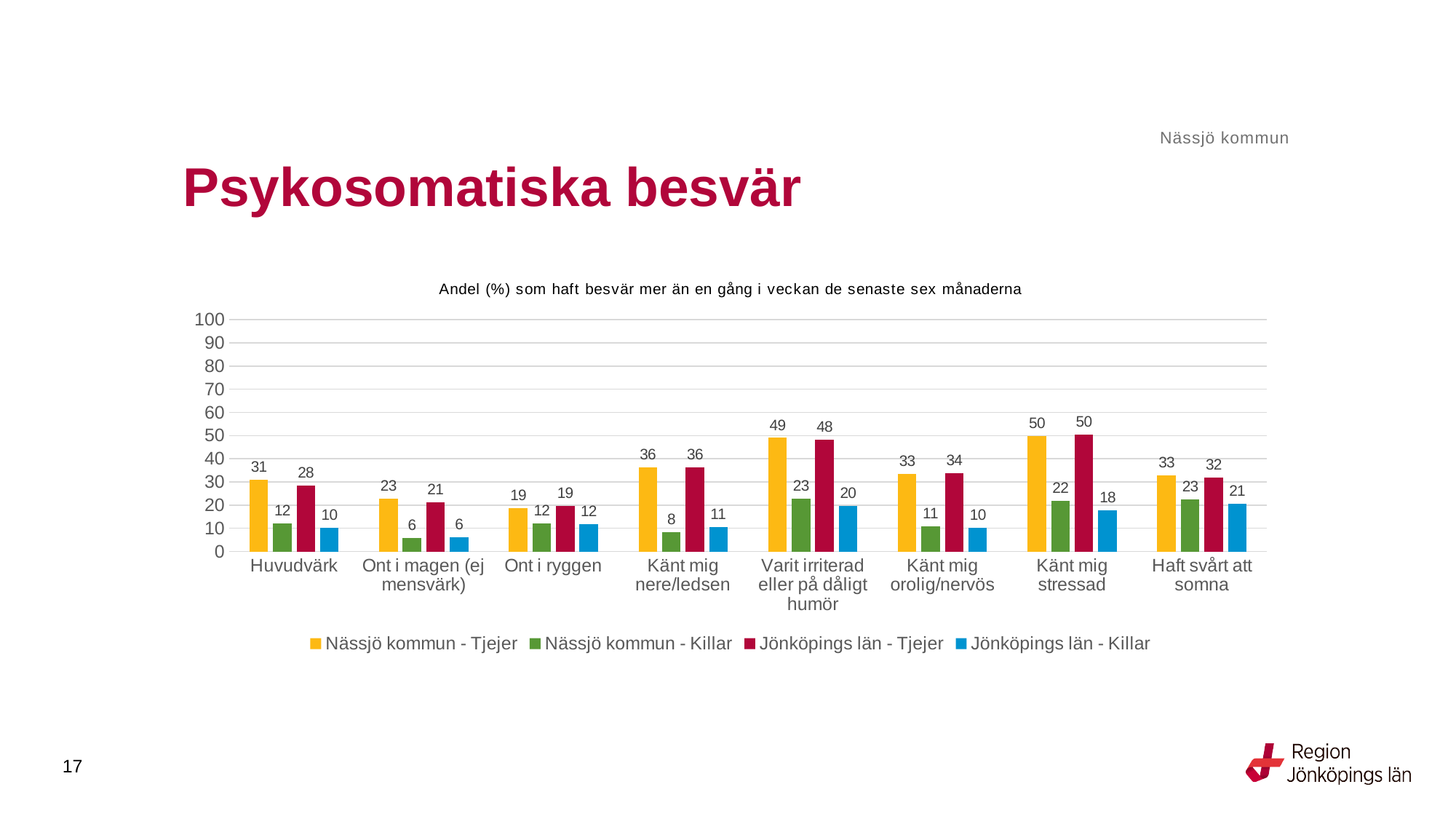
What is the value for Jönköpings län - Killar for Varit irriterad eller på dåligt humör? 20 How many categories are shown on the x axis? 8 What is the difference between Nässjö kommun - Tjejer and Nässjö kommun - Killar for Känt mig nere/ledsen? 28 Is the value for Jönköpings län - Tjejer for Känt mig stressad greater or less than 40? greater Which category has the highest value for Nässjö kommun - Tjejer? Känt mig stressad What kind of chart is shown on the slide? Bar chart What is the value for Nässjö kommun - Tjejer for Huvudvärk? 31 Which is larger for Känt mig orolig/nervös: Nässjö kommun - Tjejer or Jönköpings län - Tjejer? Jönköpings län - Tjejer How many series does the legend list? 4 Which category has the lowest value for Nässjö kommun - Killar? Ont i magen (ej mensvärk) What is the value for Nässjö kommun - Killar for Haft svårt att somna? 23 What is the subtitle printed above the chart? Andel (%) som haft besvär mer än en gång i veckan de senaste sex månaderna